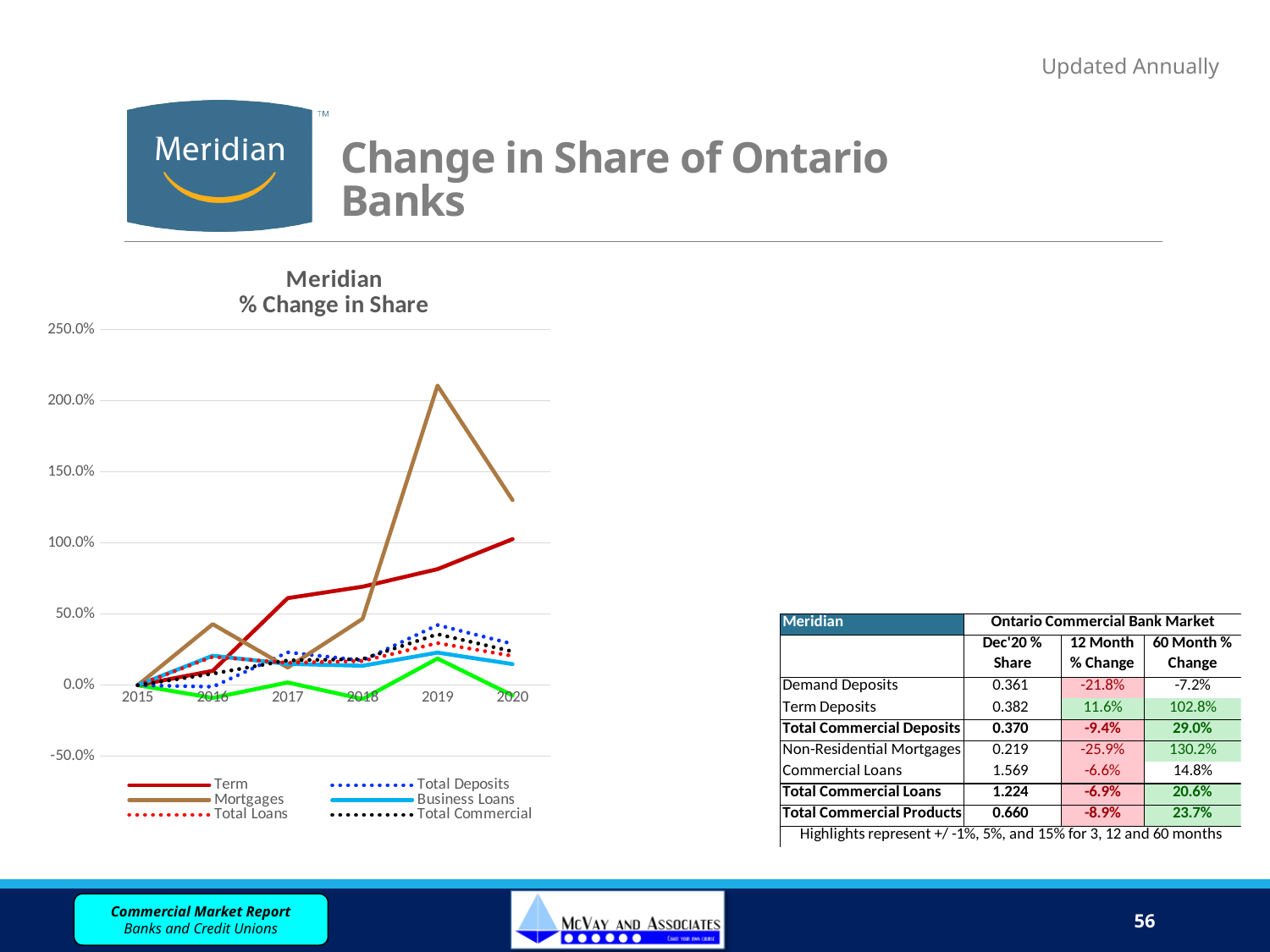
How many series does the legend of the chart list? 6 Does the Term series rise or fall from 2015 to 2020? rise Is the value for Term in 2020 greater or less than 50.0%? greater Which series reaches the highest value on the chart in 2019? Mortgages What type of chart is shown on the slide? line chart How many years are plotted along the x axis of the chart? 6 In 2017, which is larger: the value for Term or the value for Mortgages? Term Which year is the first shown on the x axis of the chart? 2015 Is the value for Business Loans in 2019 greater or less than 50.0%? less What is the title of the chart? Meridian % Change in Share Is the value for Mortgages in 2020 greater or less than 100.0%? greater